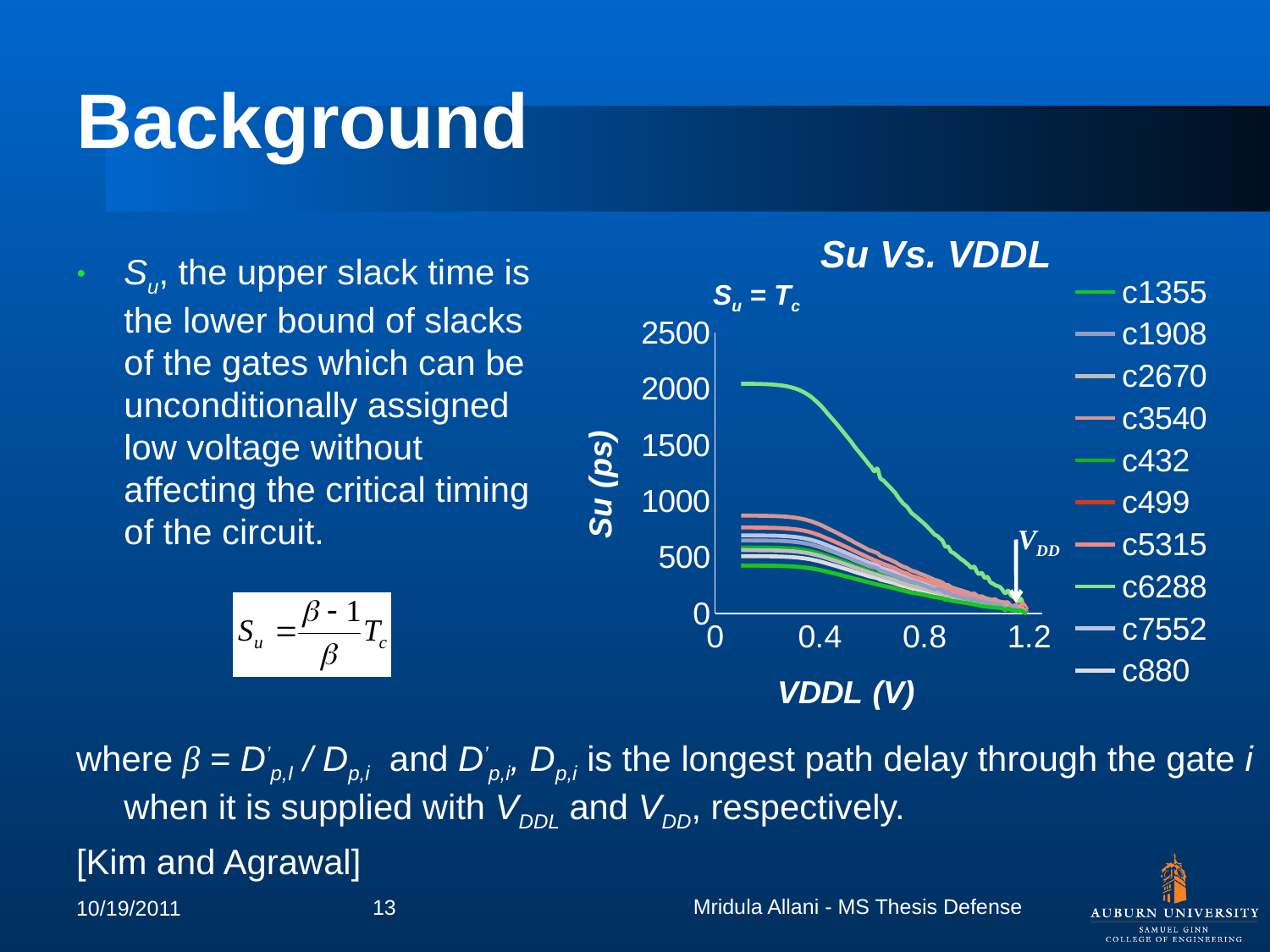
Is the Su value for c6288 at VDDL 0.2 V greater or less than 1500? greater What is the title of the chart? Su Vs. VDDL At VDDL 0.4 V, which has the larger Su value, c6288 or c499? c6288 How many series does the legend of the Su Vs. VDDL chart list? 10 As VDDL increases along the x axis, do the Su values rise or fall? fall What is the label of the y axis of the chart? Su (ps) Which circuit has the highest Su values at low VDDL? c6288 Is the Su value for c6288 at VDDL 0.8 V greater or less than 500? greater Is the Su value for c6288 at VDDL 1.2 V greater or less than 500? less What kind of chart is shown on the slide? line chart